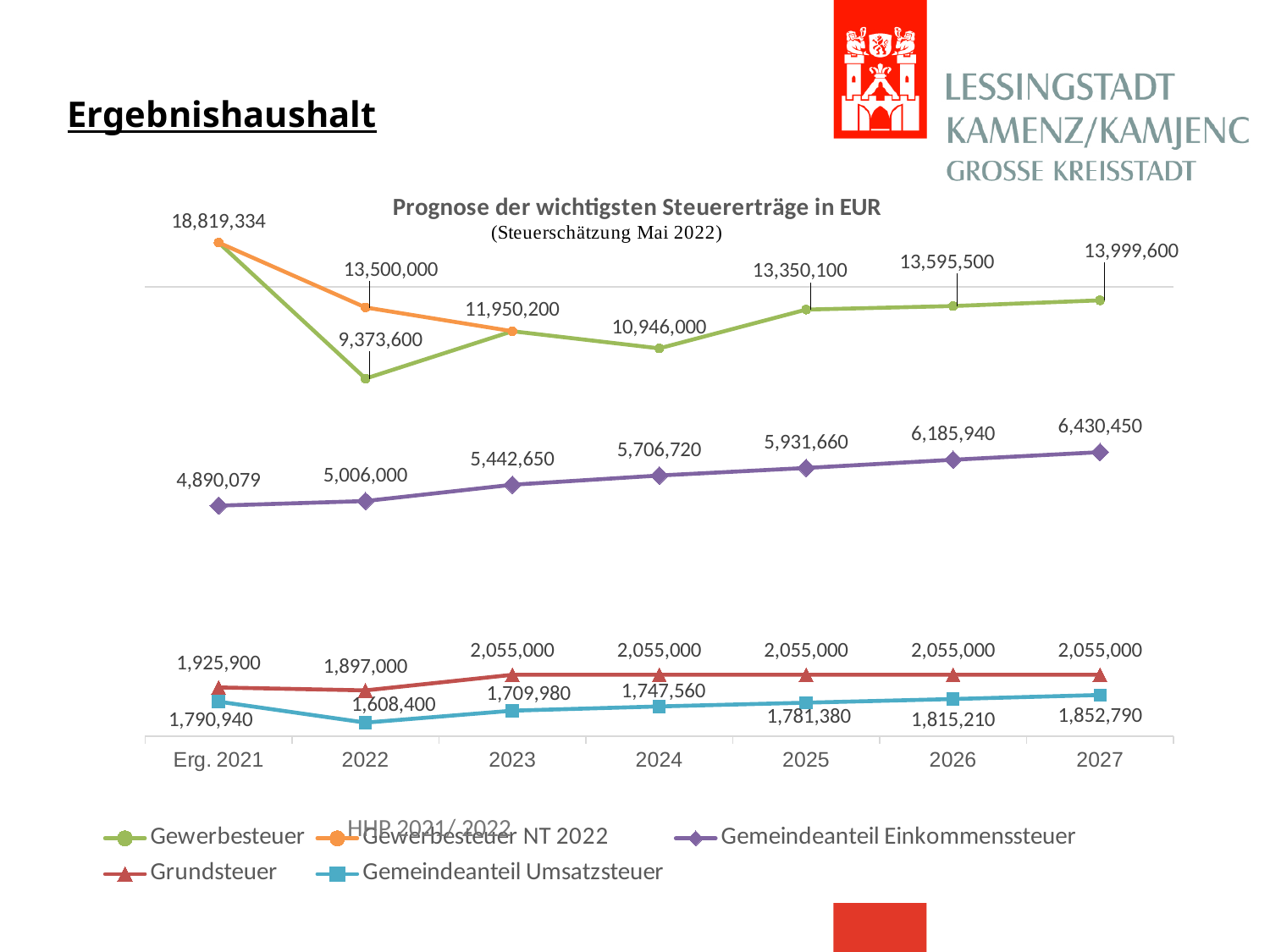
In which year is Gewerbesteuer highest? Erg. 2021 What is the difference between Gewerbesteuer NT 2022 and Gewerbesteuer in 2022? 4,126,400 What kind of chart is shown on the slide? Line chart In which year is Gemeindeanteil Umsatzsteuer lowest? 2022 What is the value of Gewerbesteuer NT 2022 in 2022? 13,500,000 How many years are shown on the x axis? 7 How many series does the legend list? 5 Does Gemeindeanteil Einkommenssteuer rise or fall from Erg. 2021 to 2027? Rise By how much does Gewerbesteuer increase from 2026 to 2027? 404,100 What is the value of Gewerbesteuer in 2022? 9,373,600 What is the value of Gemeindeanteil Einkommenssteuer in 2027? 6,430,450 Which is larger in 2024, Grundsteuer or Gemeindeanteil Umsatzsteuer? Grundsteuer